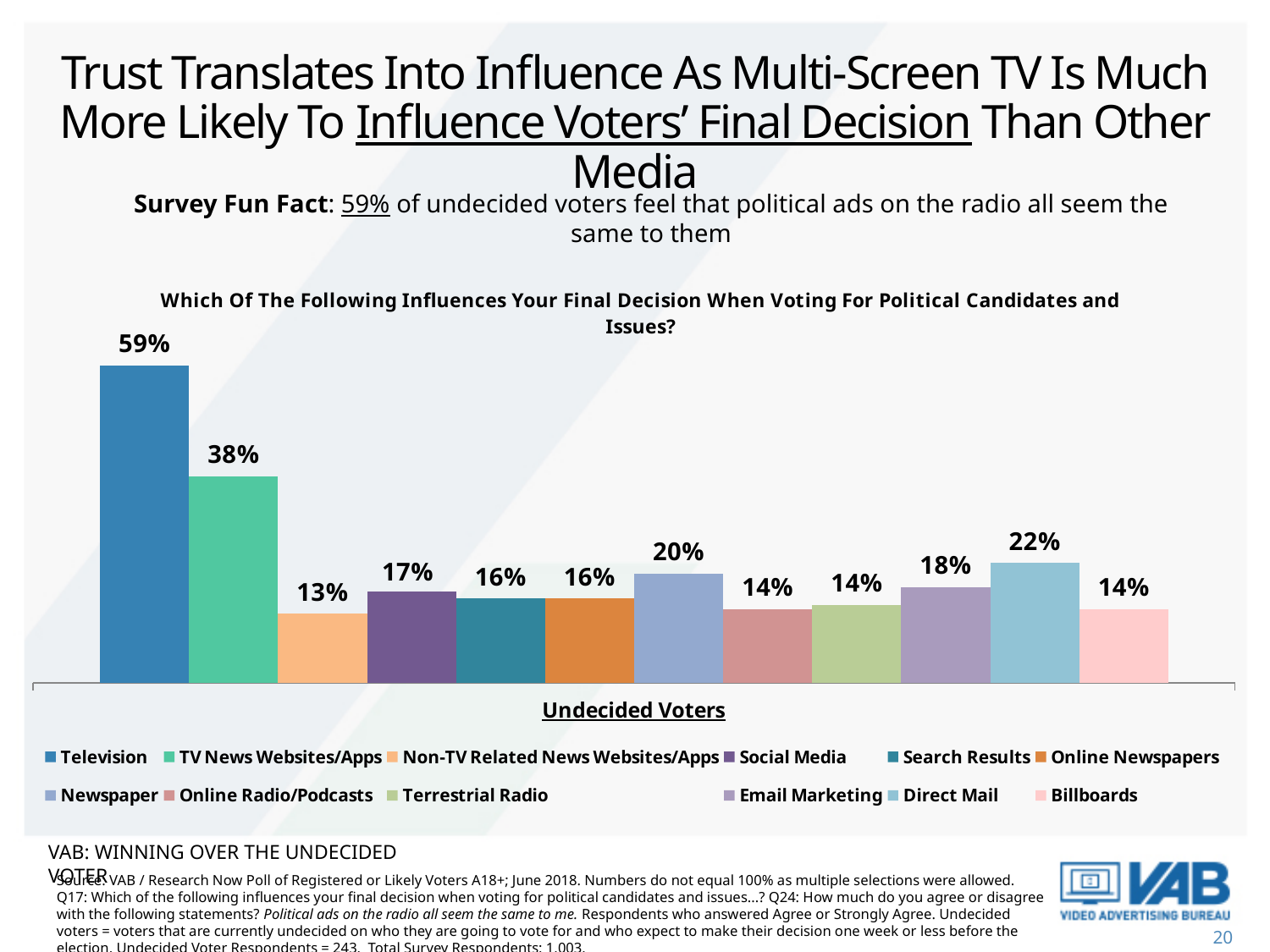
What percentage of undecided voters say Television influences their final decision? 59% What is the value shown for Direct Mail? 22% Which media source has the highest value in the chart? Television What is the value shown for TV News Websites/Apps? 38% What kind of chart is shown on the slide? Bar chart Which is larger, the value for Social Media or the value for Search Results? Social Media How many series does the legend list? 12 What is the difference between the values for Direct Mail and Newspaper? 2% Which media source has the lowest value in the chart? Non-TV Related News Websites/Apps What is the category label shown beneath the bars? Undecided Voters What is the value shown for Email Marketing? 18% What is the difference between the values for Television and TV News Websites/Apps? 21%